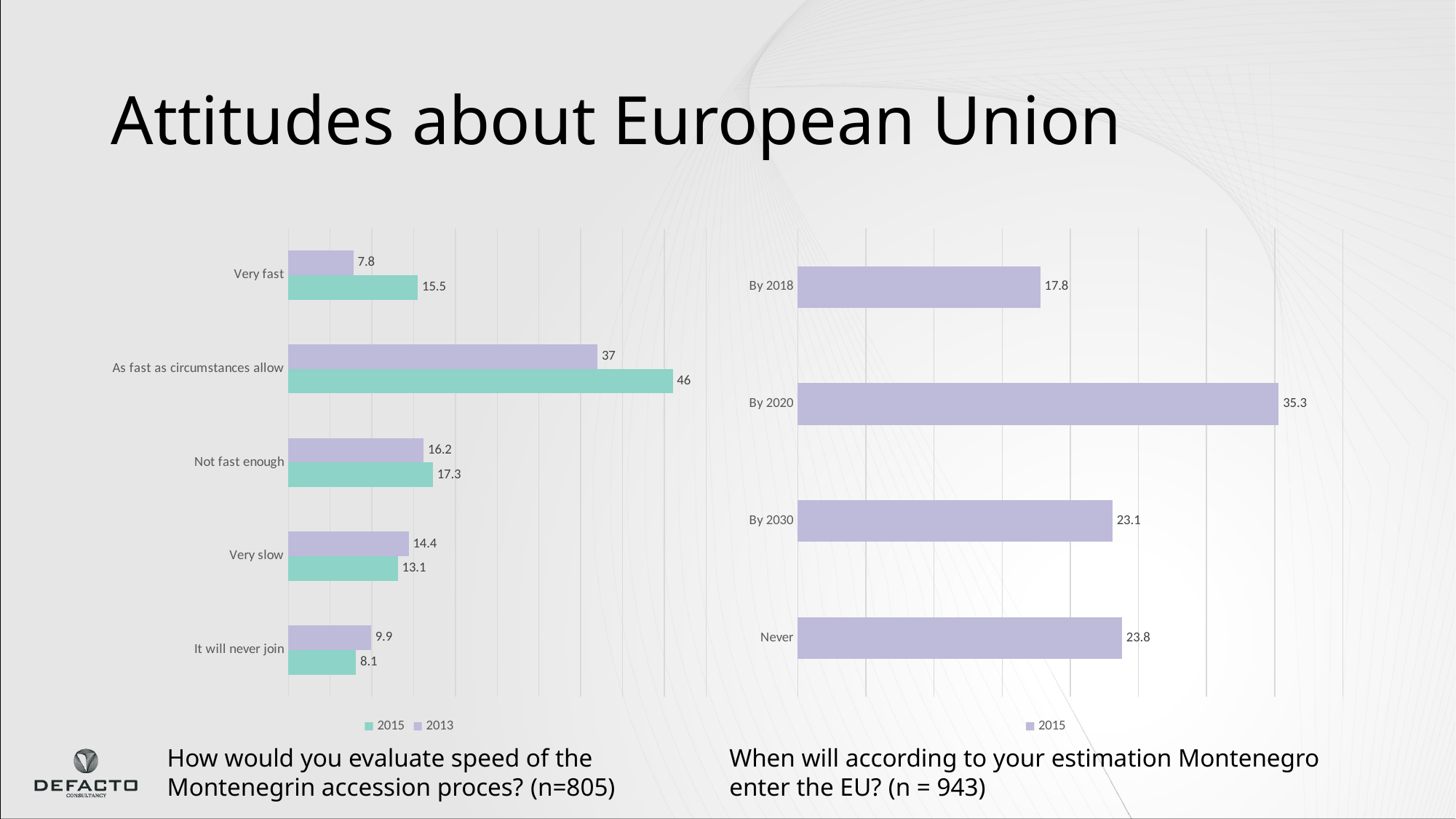
In the right chart on when Montenegro will enter the EU, what is the value for 'By 2020'? 35.3 In the left chart on the speed of the Montenegrin accession process, which category has the lowest 2013 value? Very fast In the right chart on when Montenegro will enter the EU, what is the difference between the values for 'Never' and 'By 2030'? 0.7 In the left chart on the speed of the Montenegrin accession process, what is the 2013 value for 'Very fast'? 7.8 How many categories does the left chart on the speed of the Montenegrin accession process show? 5 In the left chart on the speed of the Montenegrin accession process, which category has the highest 2015 value? As fast as circumstances allow In the left chart on the speed of the Montenegrin accession process, what is the difference between the 2015 and 2013 values for 'As fast as circumstances allow'? 9 What kind of chart is the right chart on when Montenegro will enter the EU? Bar chart In the left chart on the speed of the Montenegrin accession process, which is larger for 'Very slow': the 2015 value or the 2013 value? 2013 In the right chart on when Montenegro will enter the EU, which category has the lowest value? By 2018 In the left chart on the speed of the Montenegrin accession process, what is the 2015 value for 'As fast as circumstances allow'? 46 How many series does the legend of the left chart on the speed of the Montenegrin accession process list? 2